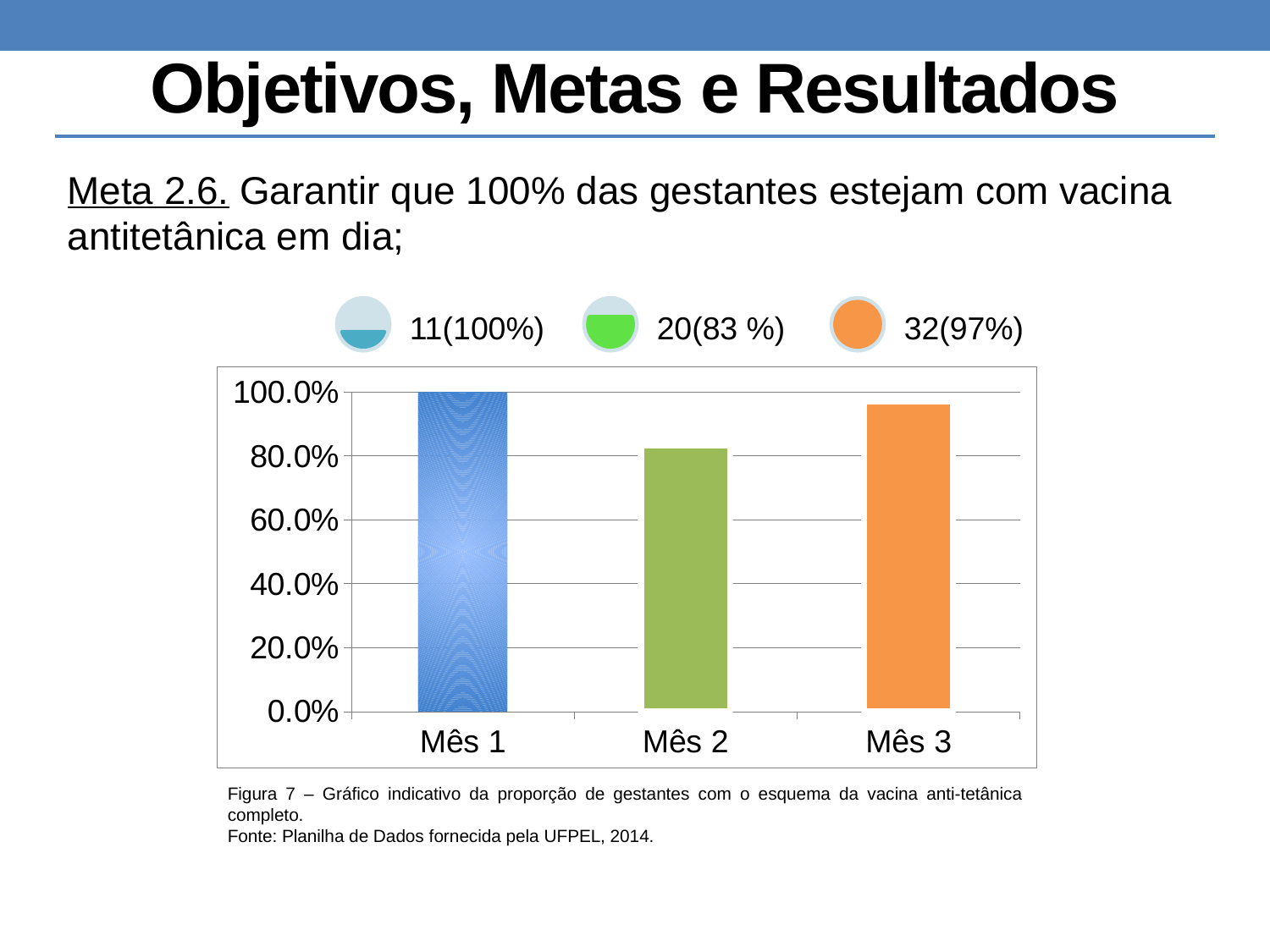
Is the value for Mês 2 greater or less than 80.0%? greater Which month has the highest bar in the chart? Mês 1 How many categories are plotted on the x axis of the chart? 3 What kind of chart is shown on the slide? bar chart What label is printed next to the green circle above the chart? 20(83 %) Is the value for Mês 3 greater or less than 100.0%? less What value does the bar for Mês 1 reach on the y axis? 100.0% What label is printed next to the orange circle above the chart? 32(97%) Do the values rise or fall from Mês 1 to Mês 2? fall Which month has the lowest bar in the chart? Mês 2 Which is larger, the value for Mês 2 or the value for Mês 3? Mês 3 Is the value for Mês 2 greater or less than 100.0%? less